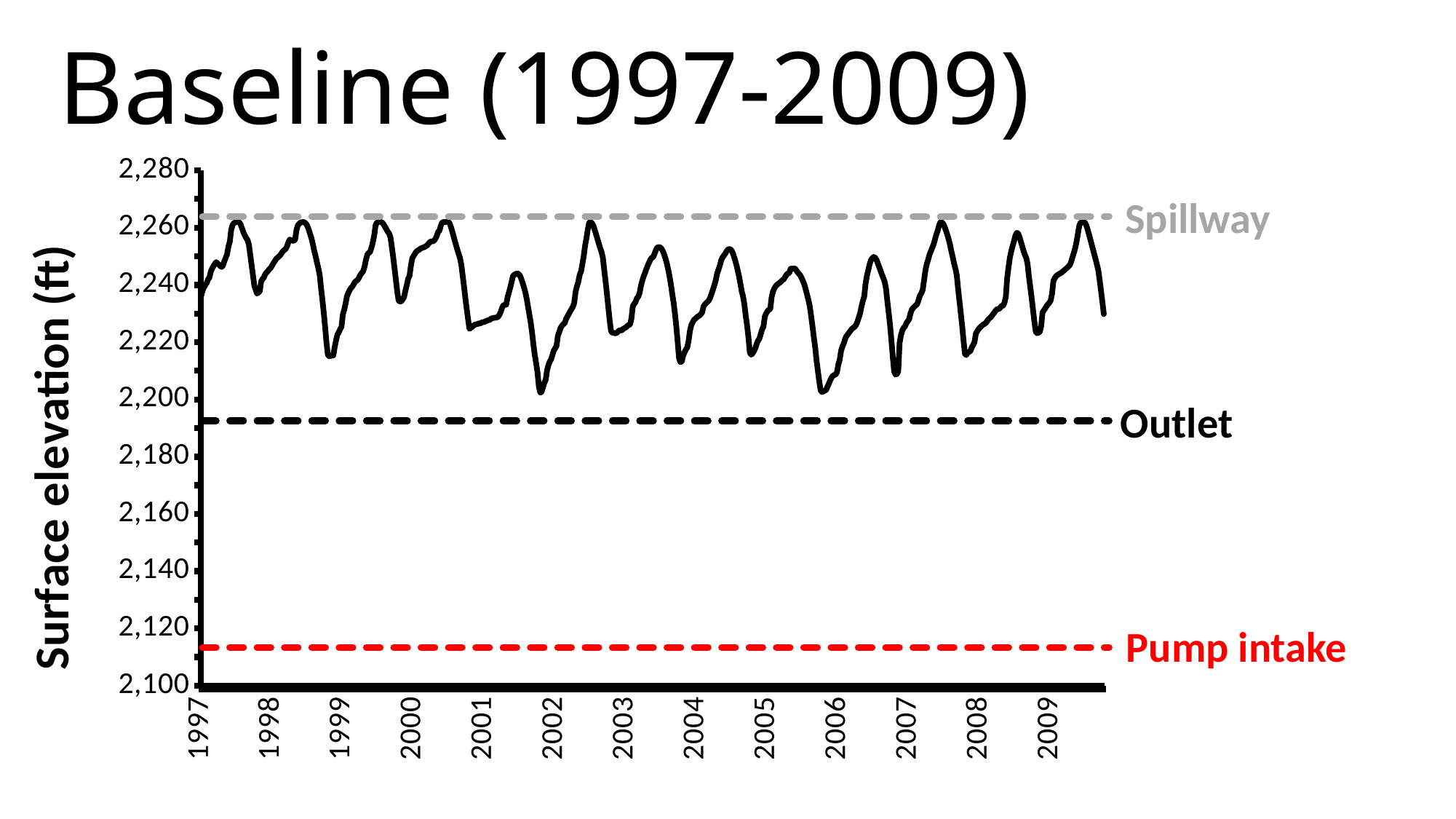
Which is higher on the chart, the Outlet line or the Pump intake line? Outlet What is the title of the slide's chart? Baseline (1997-2009) How many year labels are shown along the horizontal axis? 13 Is the Outlet reference line greater or less than 2,200 ft? less Which of the three dashed reference lines is the lowest on the chart? Pump intake Is the Spillway reference line greater or less than 2,240 ft? greater Is the Pump intake reference line greater or less than 2,120 ft? less What kind of chart is shown on the slide? line chart What is the label of the vertical axis? Surface elevation (ft) Which of the three dashed reference lines is the highest on the chart? Spillway